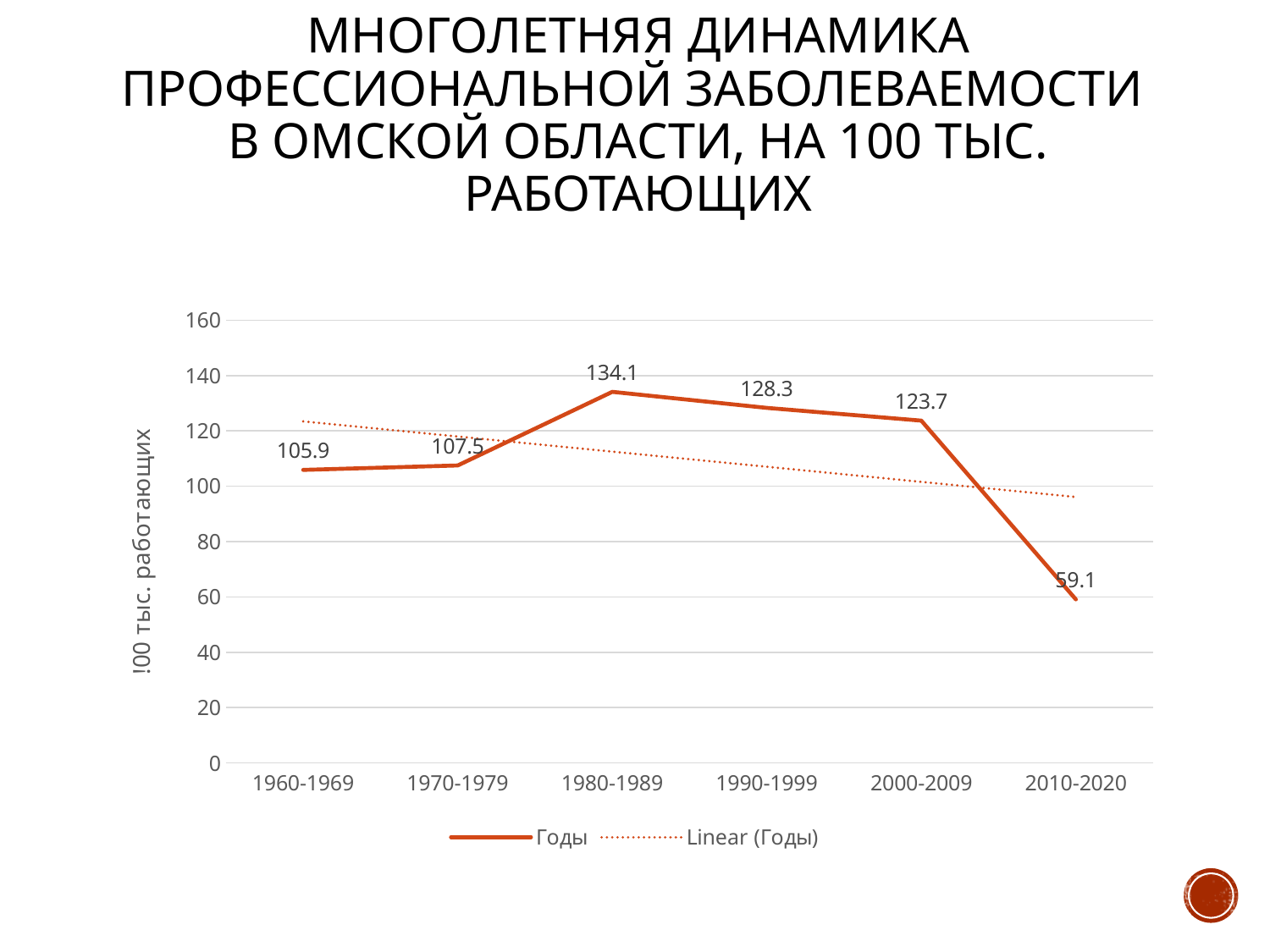
What is the value for 2010-2020? 59.1 What is the value for 1980-1989? 134.1 Which is larger, the value for 1990-1999 or the value for 2000-2009? 1990-1999 Which period has the highest value? 1980-1989 Is the value for 1970-1979 greater or less than 120? less What is the difference between the values for 2000-2009 and 2010-2020? 64.6 How many periods are shown on the x axis? 6 How many entries does the legend list? 2 Which period has the lowest value? 2010-2020 What is the value for 1960-1969? 105.9 What is the difference between the values for 1980-1989 and 1970-1979? 26.6 What kind of chart is shown on the slide? line chart